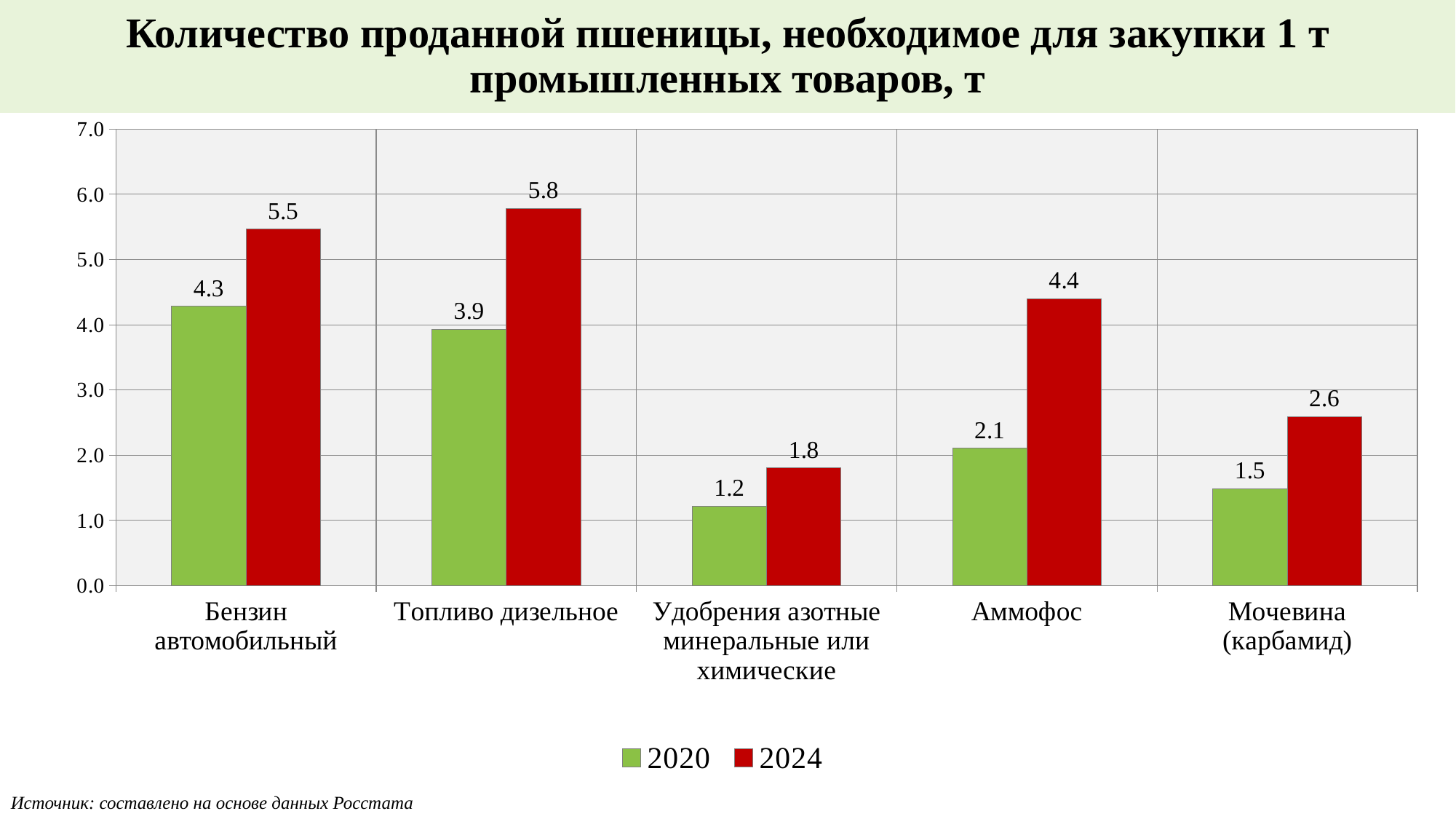
Which colour represents the 2024 series in the legend? Red What is the difference between the 2024 and 2020 values for Аммофос? 2.3 What is the difference between the 2024 values for Бензин автомобильный and Мочевина (карбамид)? 2.9 What is the 2020 value for Аммофос? 2.1 Which is larger: the 2020 value for Бензин автомобильный or the 2024 value for Аммофос? 2024 value for Аммофос Which category has the lowest 2020 value? Удобрения азотные минеральные или химические What kind of chart is shown on the slide? Bar chart Which category has the highest 2024 value? Топливо дизельное How many series does the legend list? 2 What is the 2020 value for Мочевина (карбамид)? 1.5 How many categories are shown on the x axis? 5 What is the 2024 value for Топливо дизельное? 5.8